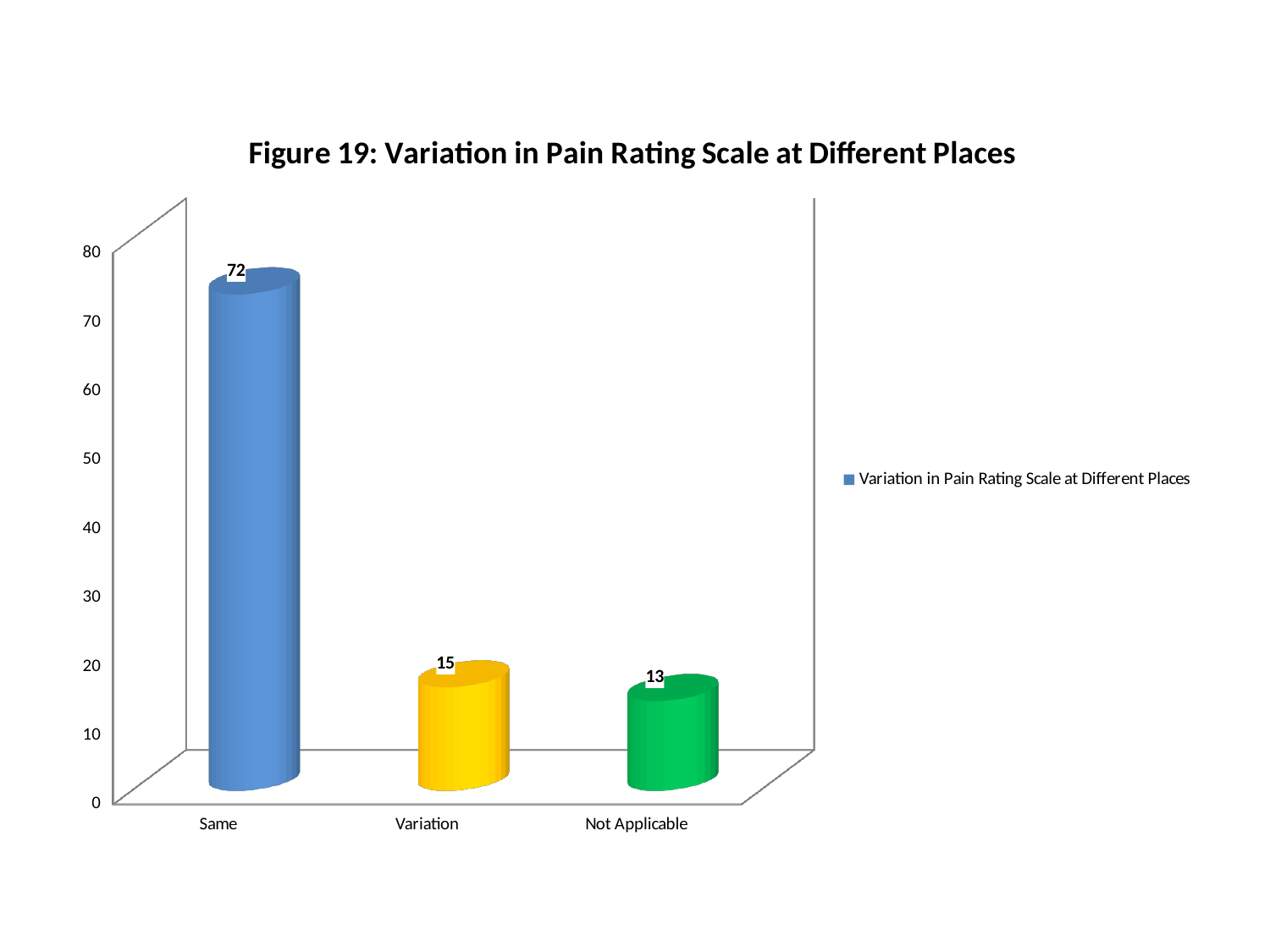
Is the value for Same greater or less than 50? greater What is the difference between the values for Variation and Not Applicable? 2 What is the difference between the values for Same and Variation? 57 What kind of chart is shown on the slide? bar chart Which category has the highest value? Same What is the value for Variation? 15 How many categories are shown on the x axis? 3 What is the title of the chart? Figure 19: Variation in Pain Rating Scale at Different Places What is the value for Not Applicable? 13 Which category has the lowest value? Not Applicable What is the value for Same? 72 Which is larger, the value for Same or the value for Not Applicable? Same